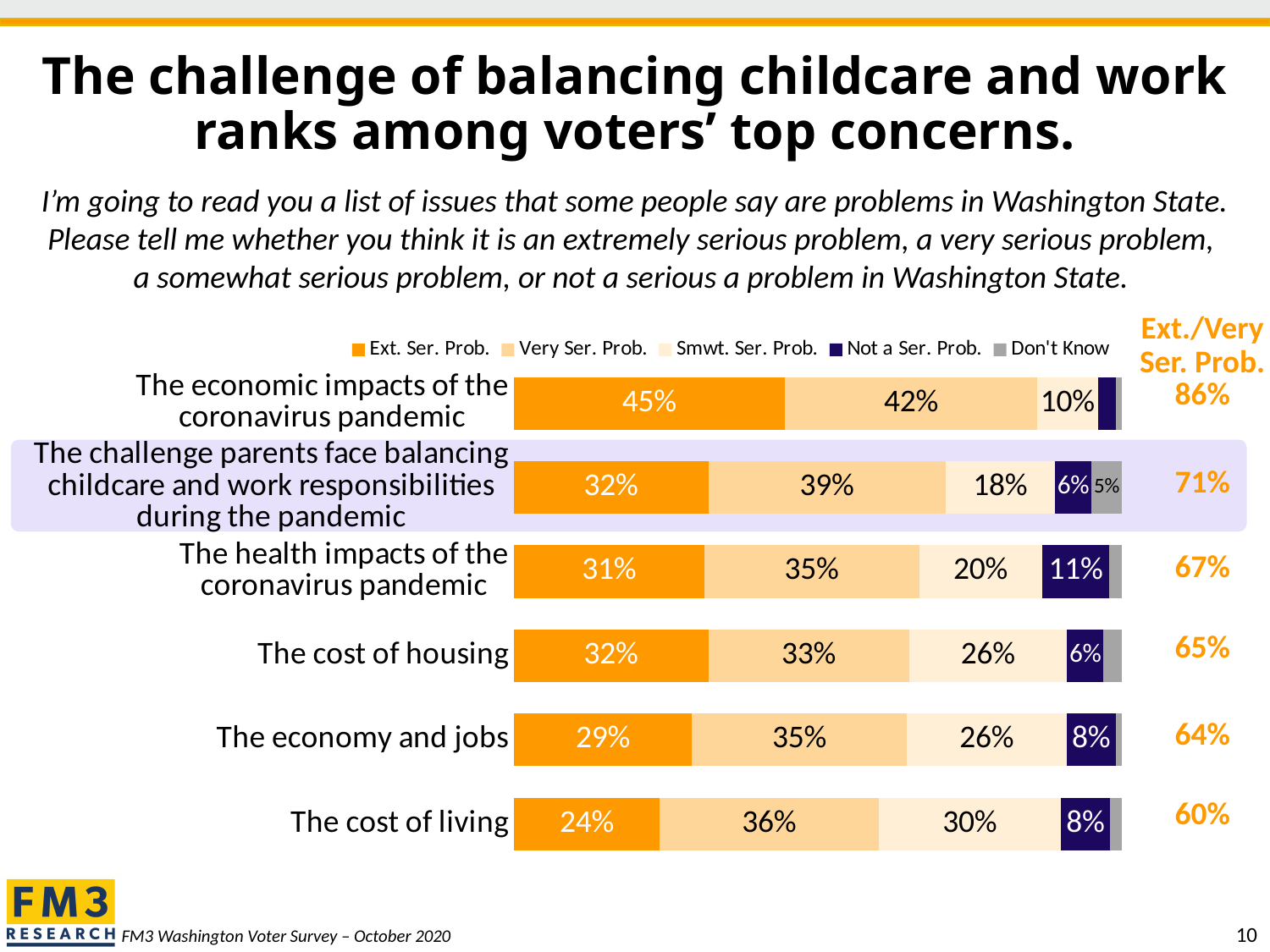
What is the Not a Ser. Prob. value for 'The health impacts of the coronavirus pandemic'? 11% Which has a larger Very Ser. Prob. value: the challenge parents face balancing childcare and work, or the economy and jobs? The challenge parents face balancing childcare and work responsibilities during the pandemic What is the combined Ext./Very Ser. Prob. figure shown for the challenge parents face balancing childcare and work responsibilities during the pandemic? 71% How many percentage points higher is the Ext. Ser. Prob. value for the economic impacts of the coronavirus pandemic than for the cost of living? 21 percentage points Which issue has the highest Ext. Ser. Prob. percentage? The economic impacts of the coronavirus pandemic Which issue has the lowest Ext. Ser. Prob. percentage? The cost of living How many issues are listed in the chart? 6 What is the Smwt. Ser. Prob. value for 'The cost of housing'? 26% What kind of chart is shown on the slide? Stacked bar chart What is the Very Ser. Prob. value for 'The cost of living'? 36% How many series does the legend list? 5 What percentage of voters rated the economic impacts of the coronavirus pandemic as an extremely serious problem (Ext. Ser. Prob.)? 45%